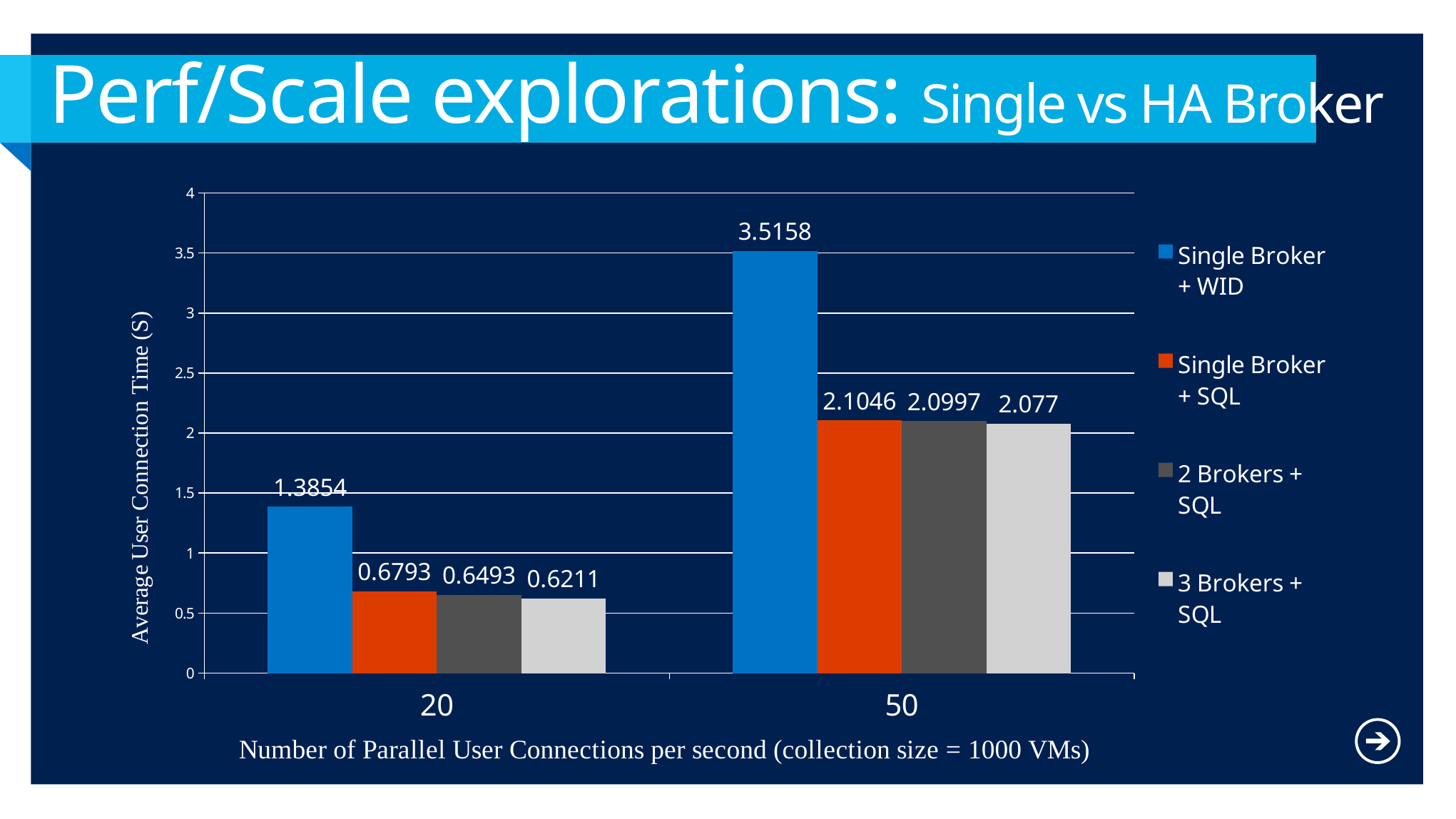
Which is larger: 2 Brokers + SQL at 20 or Single Broker + SQL at 20? Single Broker + SQL at 20 Which series has the highest value at 20 parallel user connections per second? Single Broker + WID What is the value for Single Broker + SQL at 50 parallel user connections per second? 2.1046 What is the difference between Single Broker + WID and Single Broker + SQL at 50 parallel user connections per second? 1.4112 What is the value for 3 Brokers + SQL at 20 parallel user connections per second? 0.6211 What is the difference between the Single Broker + WID values at 50 and at 20 parallel user connections per second? 2.1304 Which series has the lowest value at 50 parallel user connections per second? 3 Brokers + SQL What is the Average User Connection Time for Single Broker + WID at 50 parallel user connections per second? 3.5158 What is the label of the y axis? Average User Connection Time (S) What kind of chart is shown on the slide? Bar chart Is the value for Single Broker + WID at 50 greater or less than 3? greater How many series does the legend list? 4